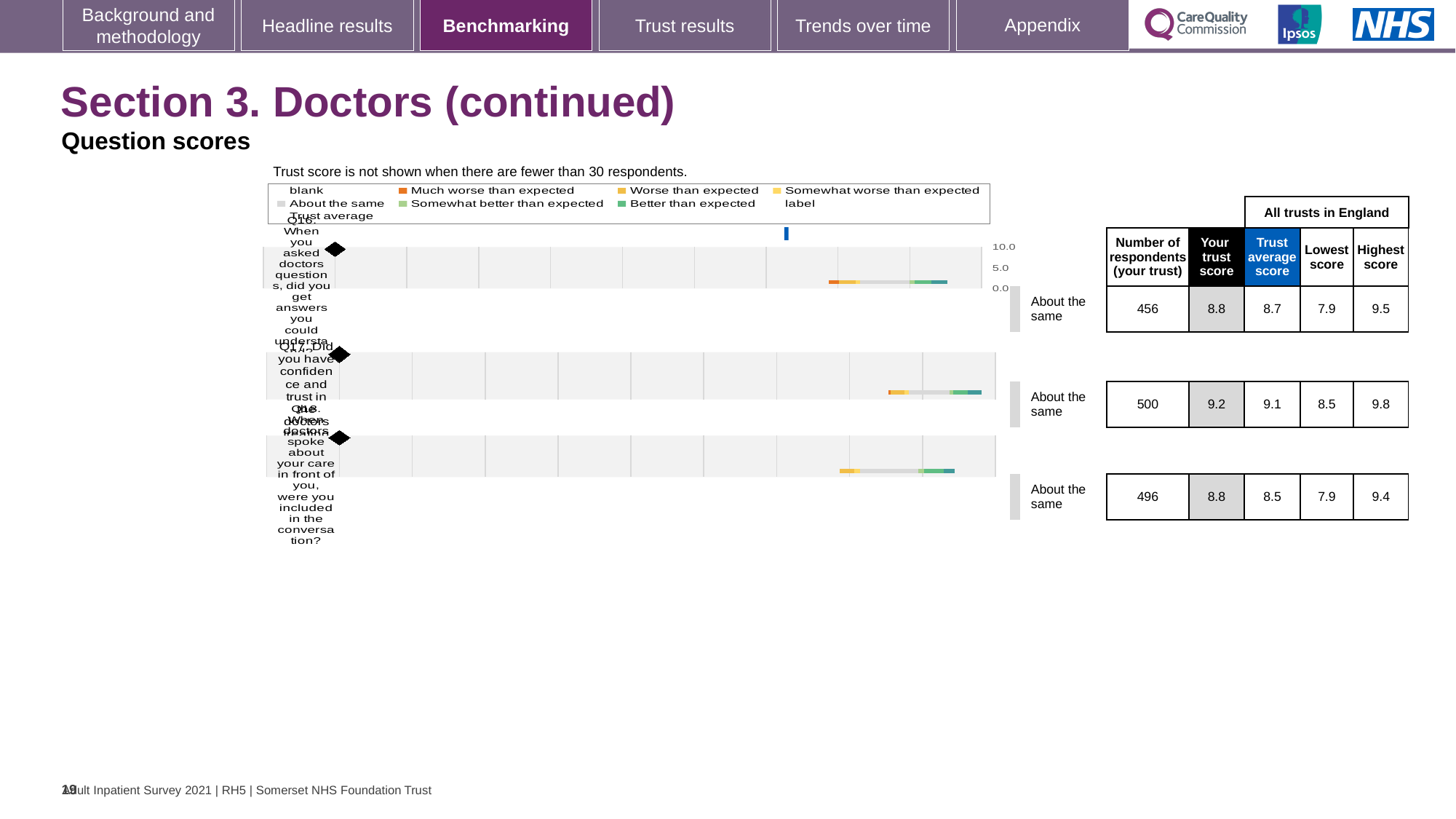
What benchmark category is shown for all three questions (Q16, Q17, Q18)? About the same Which question has the highest 'Your trust score'? Q17 What is the 'Your trust score' for Q17 (Did you have confidence and trust in the doctors treating you)? 9.2 How many questions (categories) are plotted in the question scores chart? 3 What is the difference between the highest score (9.5) and the lowest score (7.9) for Q16? 1.6 For Q18, which is larger: your trust score or the trust average score? Your trust score What is the 'Your trust score' for Q16 (When you asked doctors questions, did you get answers you could understand)? 8.8 Which question has the lowest trust average score? Q18 How many respondents from your trust answered Q17? 500 What kind of chart is used to show the question scores on this slide? bar chart Is the trust score for Q17 greater or less than 5.0 on the chart axis? greater What is the trust average score for Q18 (When doctors spoke about your care in front of you, were you included in the conversation)? 8.5